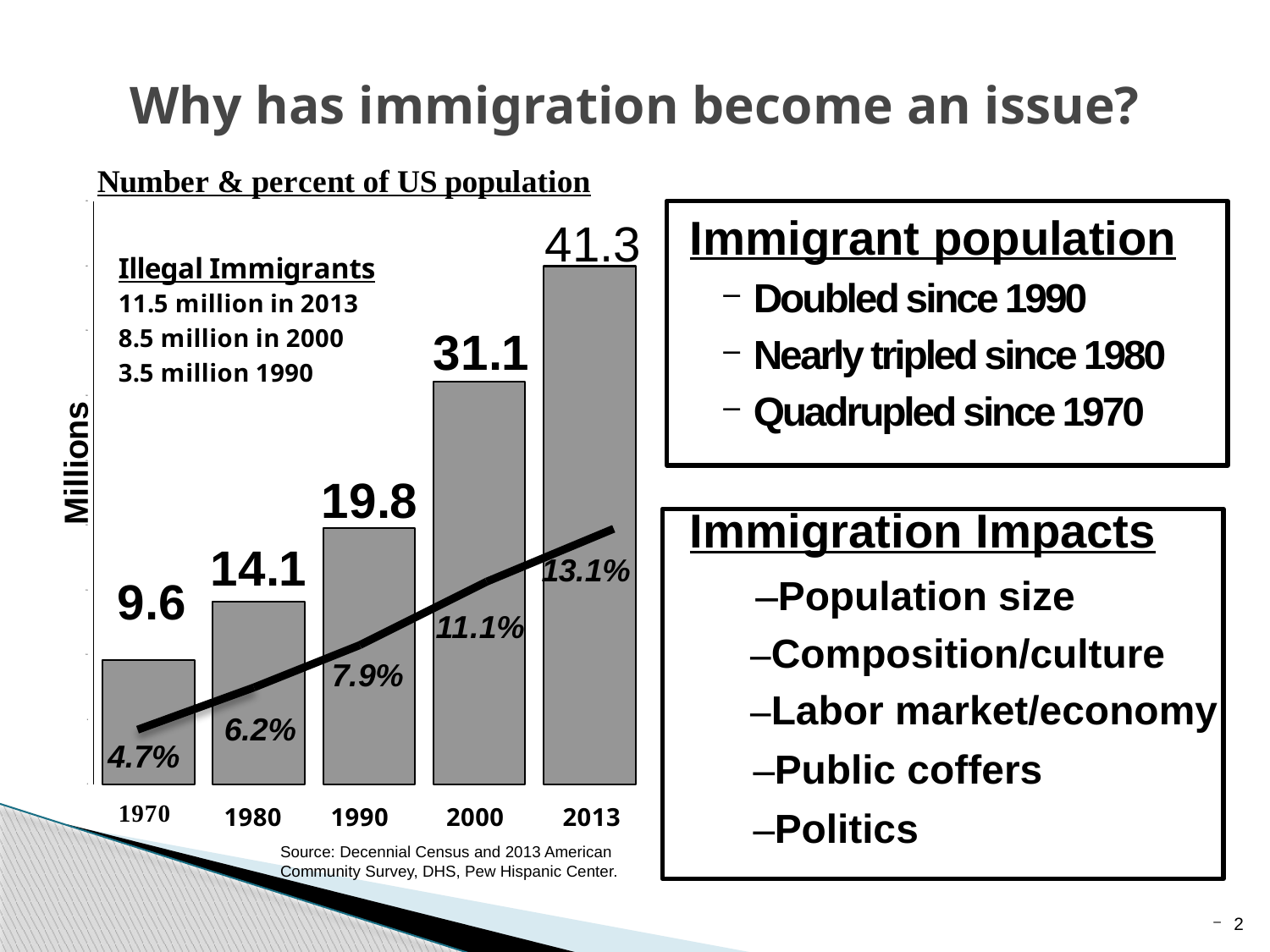
Which is larger, the bar for 1980 or the bar for 1990? 1990 What is the immigrant population in millions shown for 2000? 31.1 What is the difference between the bar values for 2013 and 2000? 10.2 Which year has the lowest percent of US population on the line? 1970 What percent of the US population does the line show for 1990? 7.9% Which year has the highest bar? 2013 Do the bar values rise or fall from 1970 to 2013? rise What is the value of the bar for 1970? 9.6 What kind of chart is used to show the number of immigrants in millions? bar chart What is the difference between the bar values for 1990 and 1980? 5.7 What is the label on the vertical axis of the chart? Millions How many years are shown on the x axis of the chart? 5